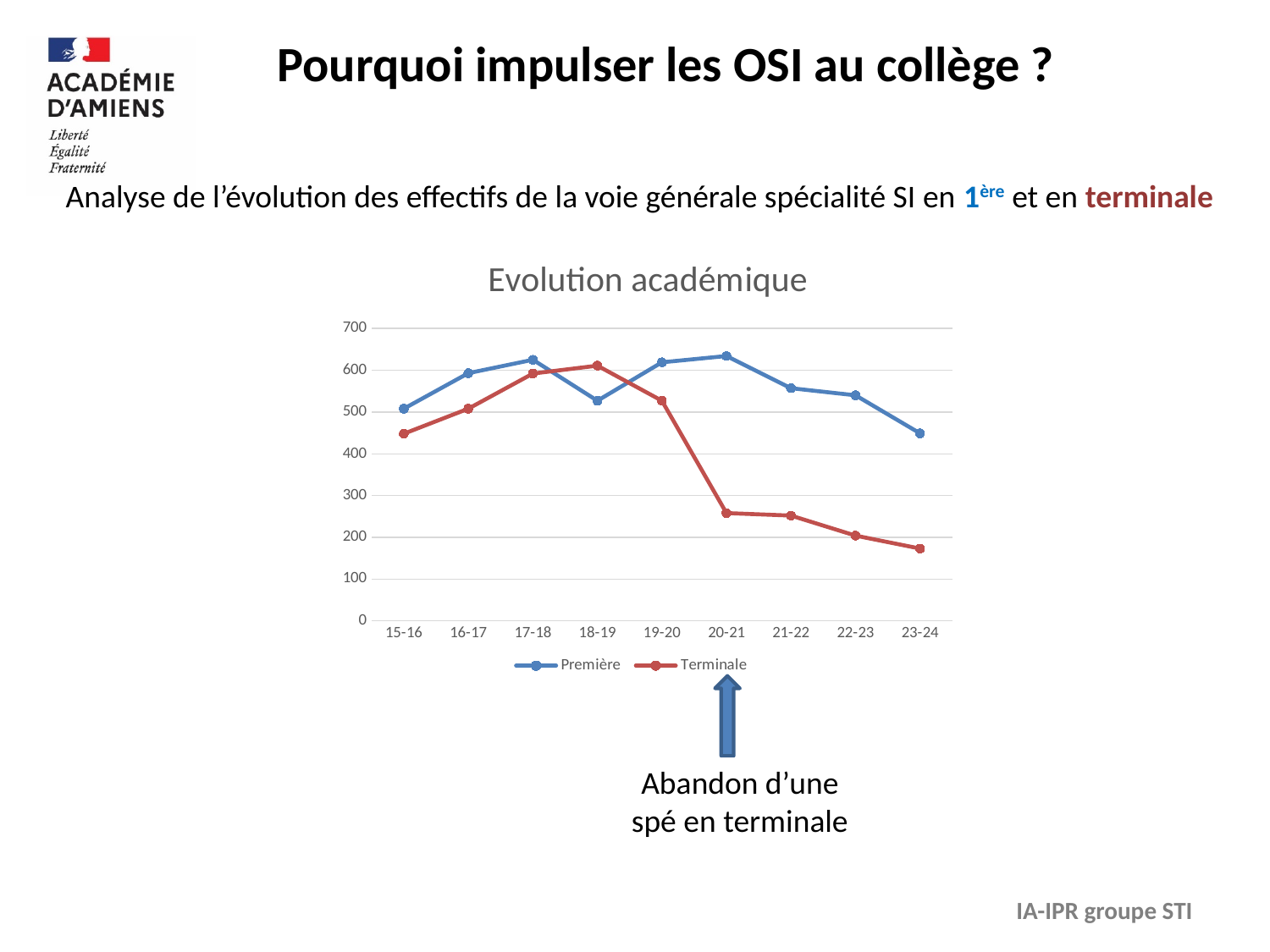
How many school years are plotted along the x axis? 9 Is the Première value for 17-18 greater or less than 600? greater In which school year does the Terminale series reach its highest value? 18-19 In 18-19, which series has the higher value, Première or Terminale? Terminale Is the Terminale value for 20-21 greater or less than 300? less Does the Terminale series rise or fall between 19-20 and 23-24? fall What is the title of the chart? Evolution académique How many series does the chart legend list? 2 What kind of chart is shown on the slide? line chart In which school year does the Première series reach its lowest value? 23-24 Which series are listed in the chart legend? Première and Terminale In which school year does the Terminale series reach its lowest value? 23-24